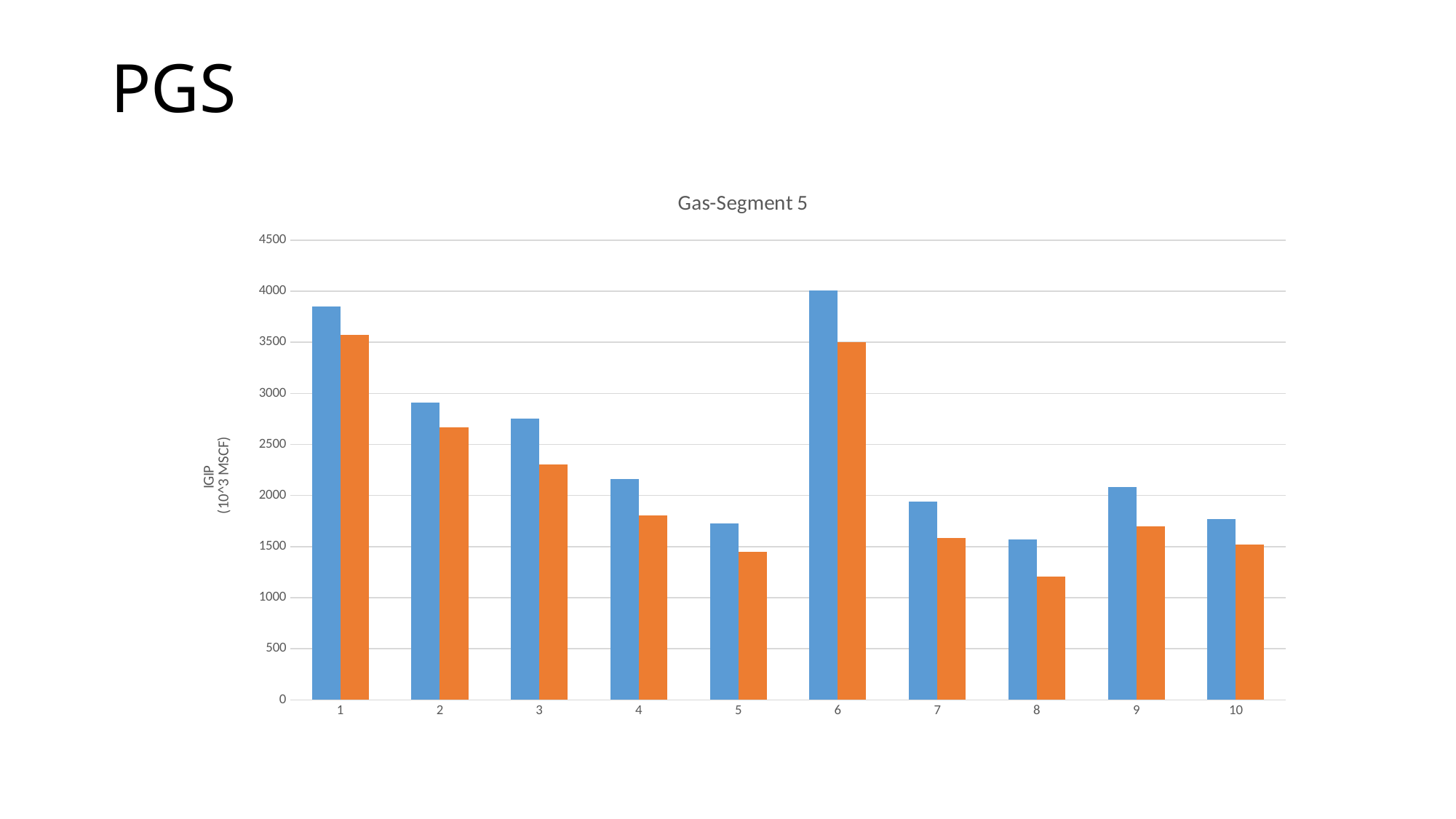
Which category has the shortest blue bar? 8 Which category has the shortest orange bar? 8 What is the label on the vertical axis of the chart? IGIP (10^3 MSCF) What is the title of the chart? Gas-Segment 5 How many categories are shown on the x axis of the chart? 10 What kind of chart is shown on the slide? bar chart Is the orange bar for category 8 greater or less than 1500? less Is the orange bar for category 4 greater or less than 2000? less Which category has the tallest blue bar? 6 Do the blue bars rise or fall from category 1 to category 5? fall Is the blue bar for category 1 greater or less than 3500? greater For category 3, which bar is taller, the blue one or the orange one? blue